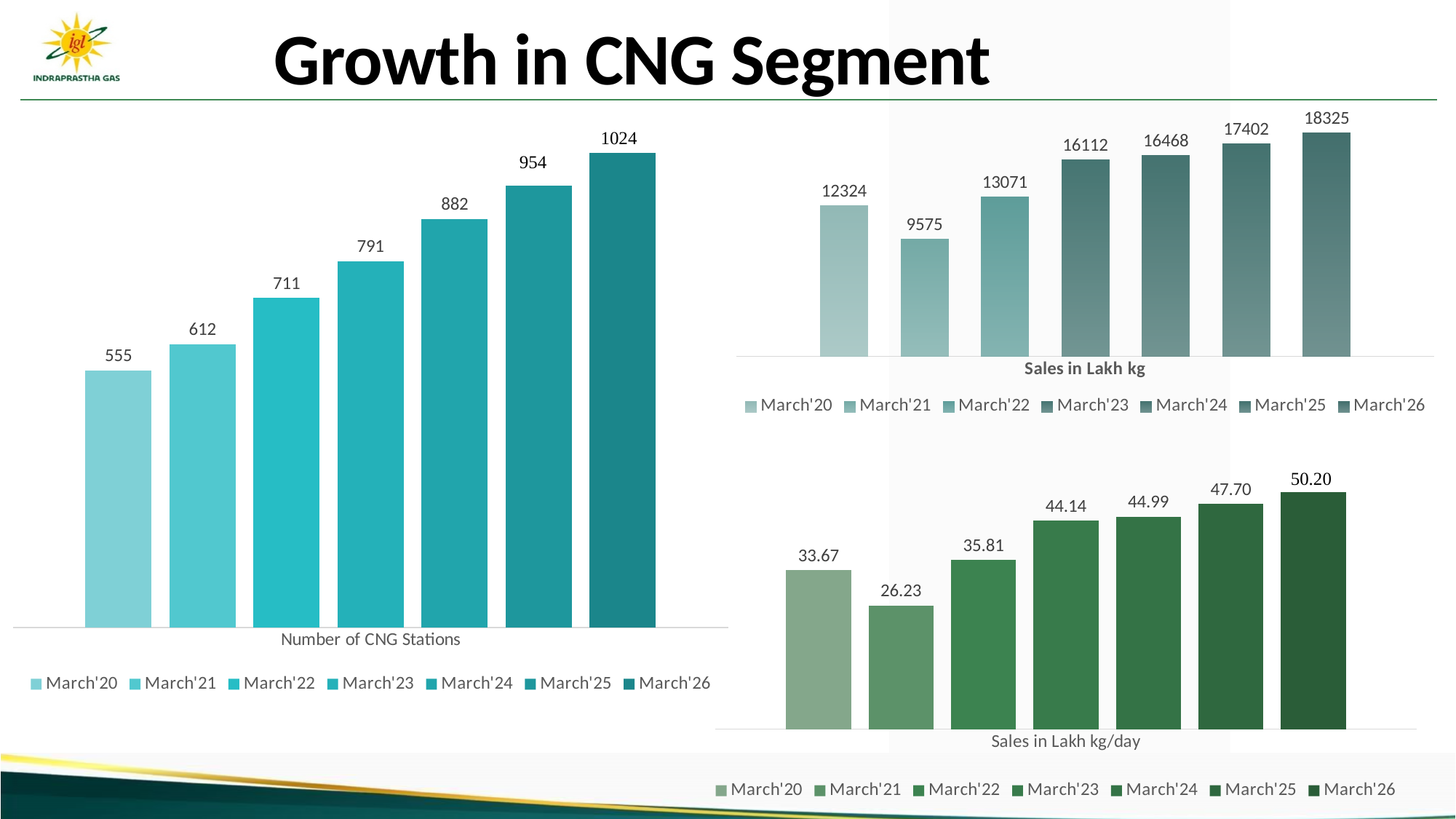
In the 'Sales in Lakh kg' chart, which is larger, the value for March'20 or the value for March'21? March'20 In the 'Number of CNG Stations' chart, what is the value for March'22? 711 In the 'Number of CNG Stations' chart, which category has the highest value? March'26 What kind of chart is the 'Number of CNG Stations' chart? Bar chart In the 'Sales in Lakh kg' chart, which category has the lowest value? March'21 In the 'Sales in Lakh kg/day' chart, what is the value for March'24? 44.99 In the 'Sales in Lakh kg/day' chart, how many entries does the legend list? 7 In the 'Sales in Lakh kg' chart, what is the difference between the March'26 and March'25 values? 923 In the 'Number of CNG Stations' chart, how many bars are plotted? 7 In the 'Number of CNG Stations' chart, what is the difference between the March'26 and March'20 values? 469 In the 'Sales in Lakh kg' chart, what is the value for March'23? 16112 In the 'Sales in Lakh kg/day' chart, what is the difference between the March'26 and March'20 values? 16.53